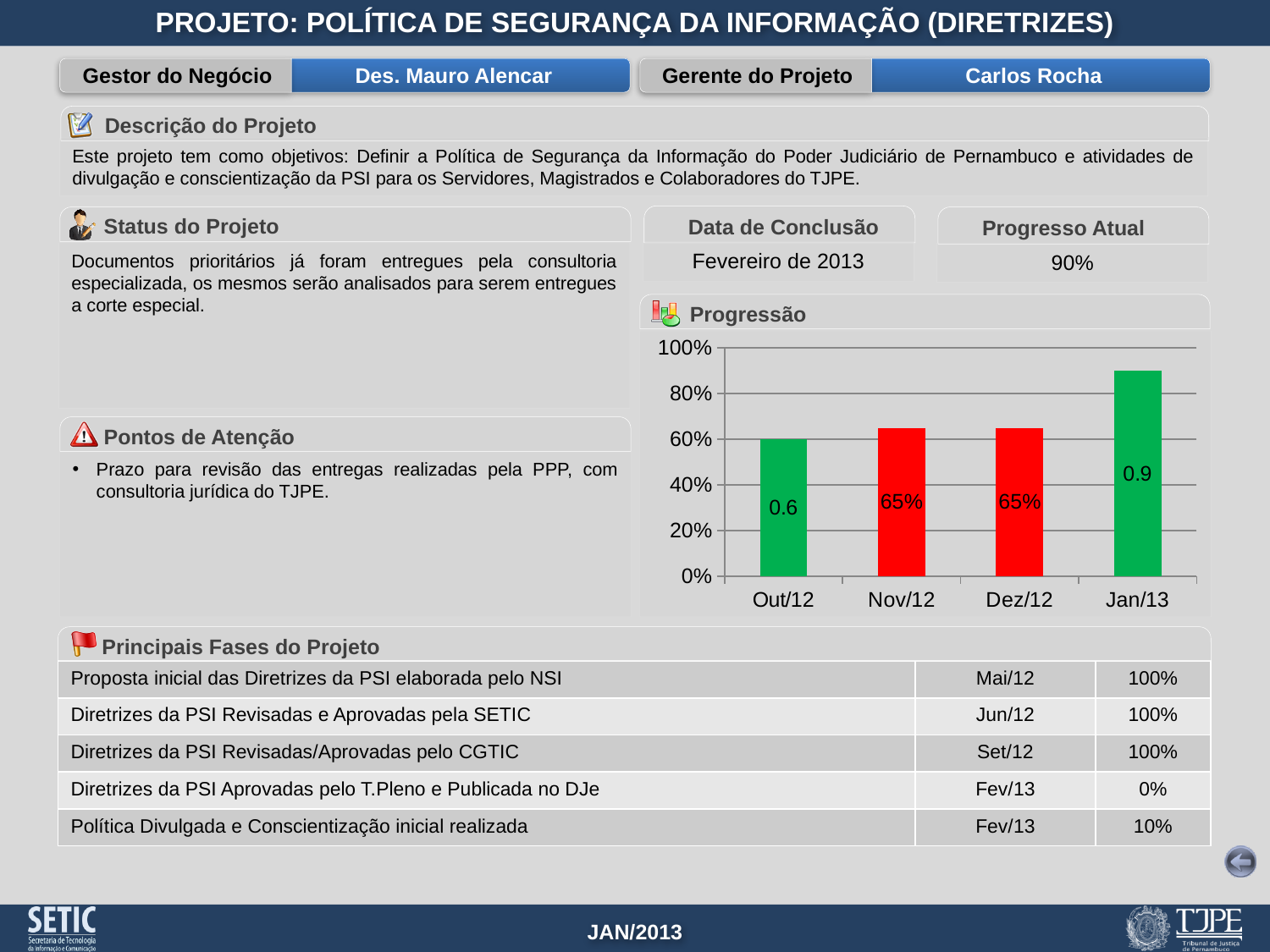
In the Progressão chart, what is the difference between the values for Nov/12 and Dez/12? 0% How many months are shown on the x axis of the Progressão chart? 4 In the Progressão chart, is the value for Out/12 greater or less than 80%? less In the Progressão chart, what is the value for Nov/12? 65% In the Progressão chart, which month has the highest bar? Jan/13 In the Progressão chart, which is larger, the value for Jan/13 or the value for Dez/12? Jan/13 What kind of chart is the Progressão chart? bar chart In the Progressão chart, do the values rise or fall from Out/12 to Jan/13? rise In the Progressão chart, what is the value for Jan/13? 0.9 In the Progressão chart, what is the value for Out/12? 0.6 In the Progressão chart, which month has the lowest bar? Out/12 In the Progressão chart, is the value for Jan/13 greater or less than 80%? greater